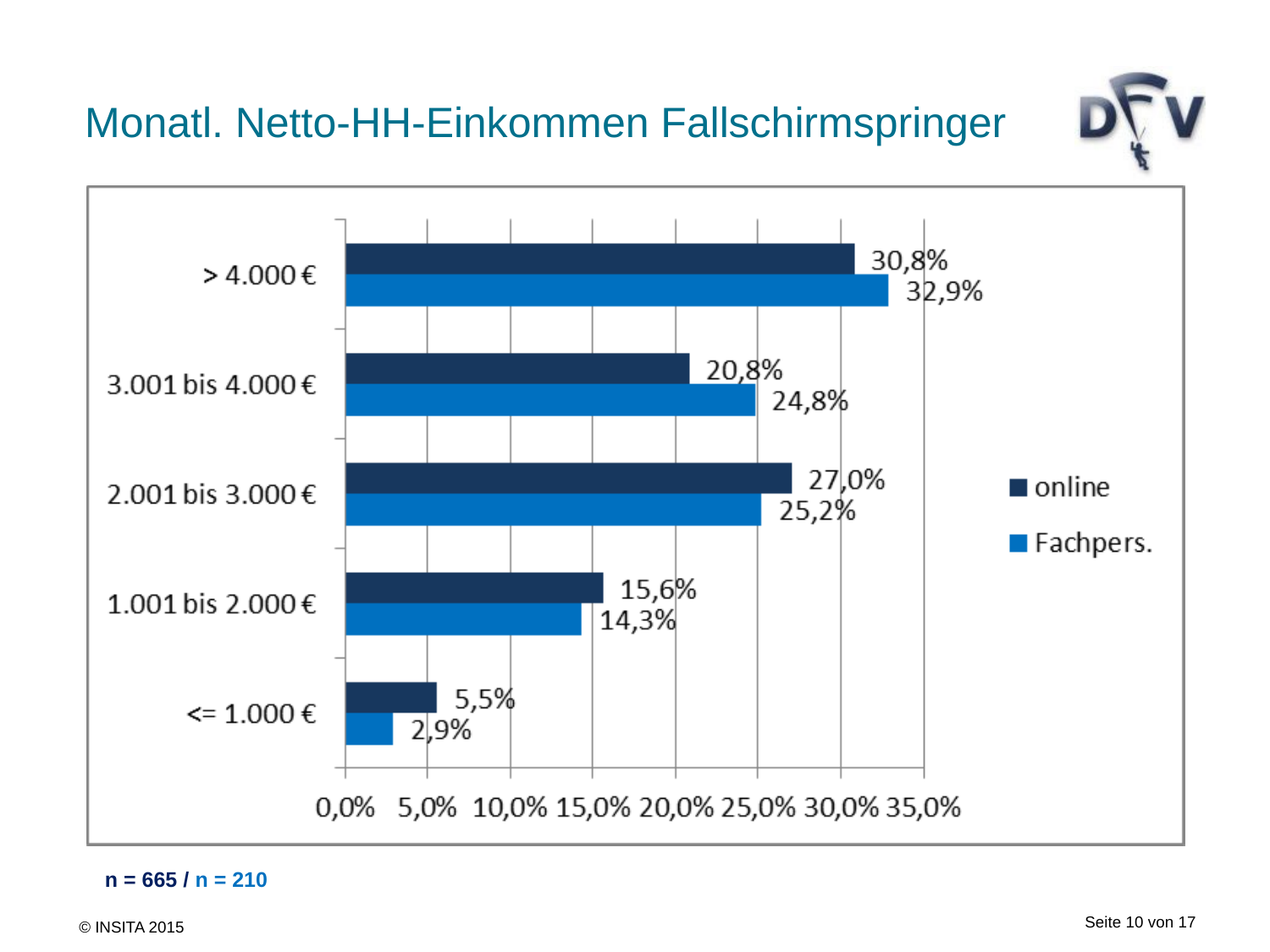
What is the value for "Fachpers." in the "3.001 bis 4.000 €" category? 24,8% What are the two series named in the legend? online and Fachpers. Which income category has the lowest value for the "Fachpers." series? <= 1.000 € What is the value for "online" in the "> 4.000 €" category? 30,8% Is the "online" value for "1.001 bis 2.000 €" greater or less than 15,0%? greater What is the difference between the "Fachpers." and "online" values in the "> 4.000 €" category? 2,1% How many series does the legend list? 2 In the "2.001 bis 3.000 €" category, which series has the larger value, "online" or "Fachpers."? online Which income category has the highest value for the "online" series? > 4.000 € What is the value for "Fachpers." in the "<= 1.000 €" category? 2,9% How many income categories are shown on the chart? 5 What kind of chart is shown on the slide? Bar chart